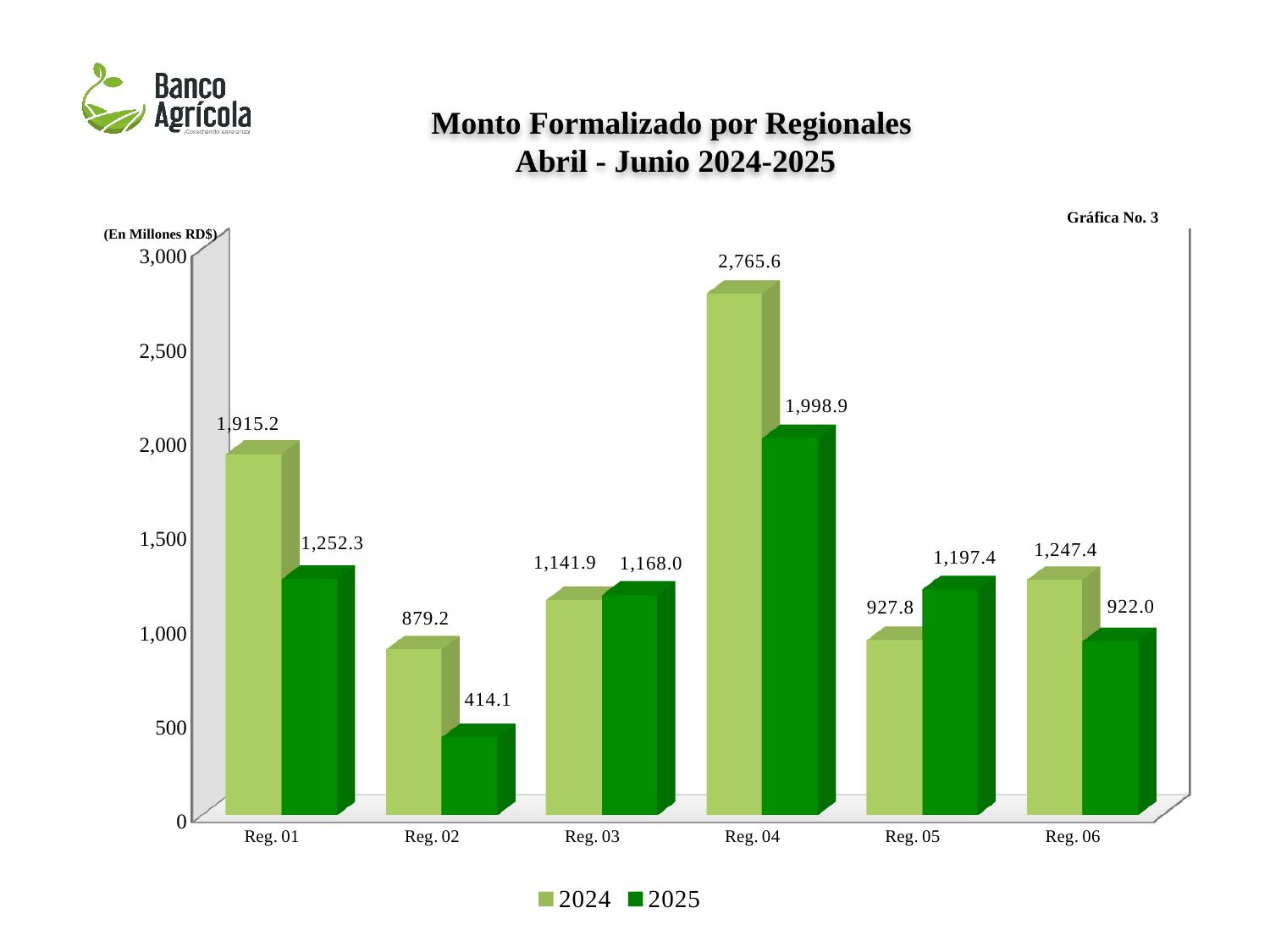
How many series does the legend list? 2 What is the difference between the 2024 and 2025 values for Reg. 04? 766.7 What is the 2025 value for Reg. 05? 1,197.4 How many regions are shown on the x axis? 6 Is the 2025 value for Reg. 01 greater or less than 1,500? less Which region has the lowest 2025 value? Reg. 02 What is the difference between the 2024 and 2025 values for Reg. 02? 465.1 What kind of chart is shown on the slide? Bar chart Which region has the highest 2024 value? Reg. 04 Which is larger for Reg. 06, the 2024 value or the 2025 value? 2024 What is the 2025 value for Reg. 02? 414.1 What is the 2024 value for Reg. 04? 2,765.6